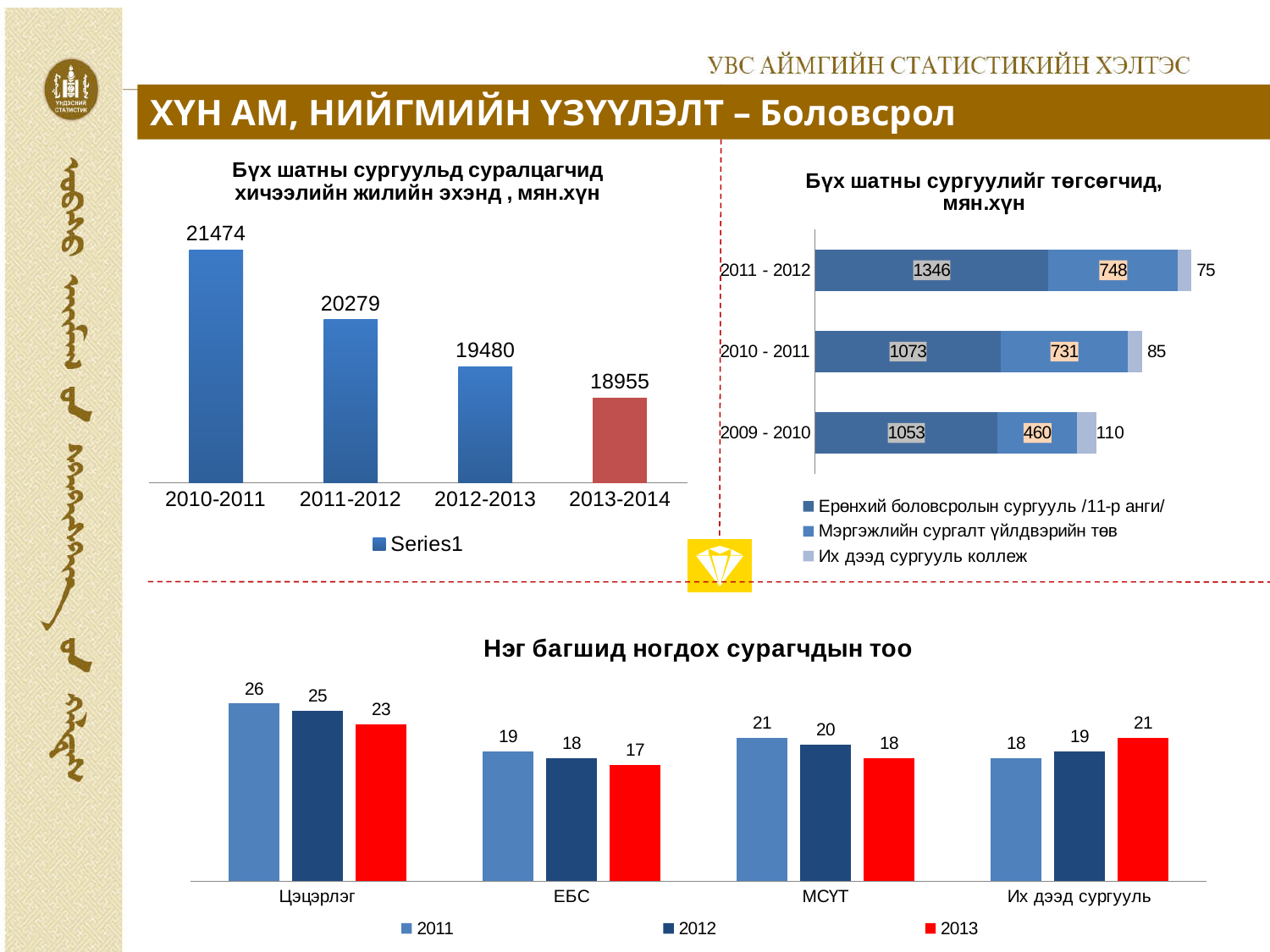
In the top-left chart 'Бүх шатны сургуульд суралцагчид хичээлийн жилийн эхэнд , мян.хүн', do the values rise or fall from 2010-2011 to 2013-2014? fall In the top-right chart 'Бүх шатны сургуулийг төгсөгчид, мян.хүн', how many series does the legend list? 3 In the top-left chart 'Бүх шатны сургуульд суралцагчид хичээлийн жилийн эхэнд , мян.хүн', what is the value for 2010-2011? 21474 In the bottom chart 'Нэг багшид ногдох сурагчдын тоо', is the 2012 value for ЕБС larger or smaller than the 2012 value for Их дээд сургууль? smaller In the top-left chart 'Бүх шатны сургуульд суралцагчид хичээлийн жилийн эхэнд , мян.хүн', which year has the lowest value? 2013-2014 In the bottom chart 'Нэг багшид ногдох сурагчдын тоо', how many categories are shown on the x axis? 4 In the top-right chart 'Бүх шатны сургуулийг төгсөгчид, мян.хүн', which year has the highest value for 'Их дээд сургууль коллеж'? 2009 - 2010 In the bottom chart 'Нэг багшид ногдох сурагчдын тоо', what is the 2013 value for МСҮТ? 18 In the top-right chart 'Бүх шатны сургуулийг төгсөгчид, мян.хүн', what is the value of 'Мэргэжлийн сургалт үйлдвэрийн төв' for 2009 - 2010? 460 In the bottom chart 'Нэг багшид ногдох сурагчдын тоо', which category has the highest 2011 value? Цэцэрлэг In the top-right chart 'Бүх шатны сургуулийг төгсөгчид, мян.хүн', what is the total of the stacked bar for 2011 - 2012? 2169 In the top-left chart 'Бүх шатны сургуульд суралцагчид хичээлийн жилийн эхэнд , мян.хүн', what is the difference between the 2011-2012 and 2012-2013 values? 799